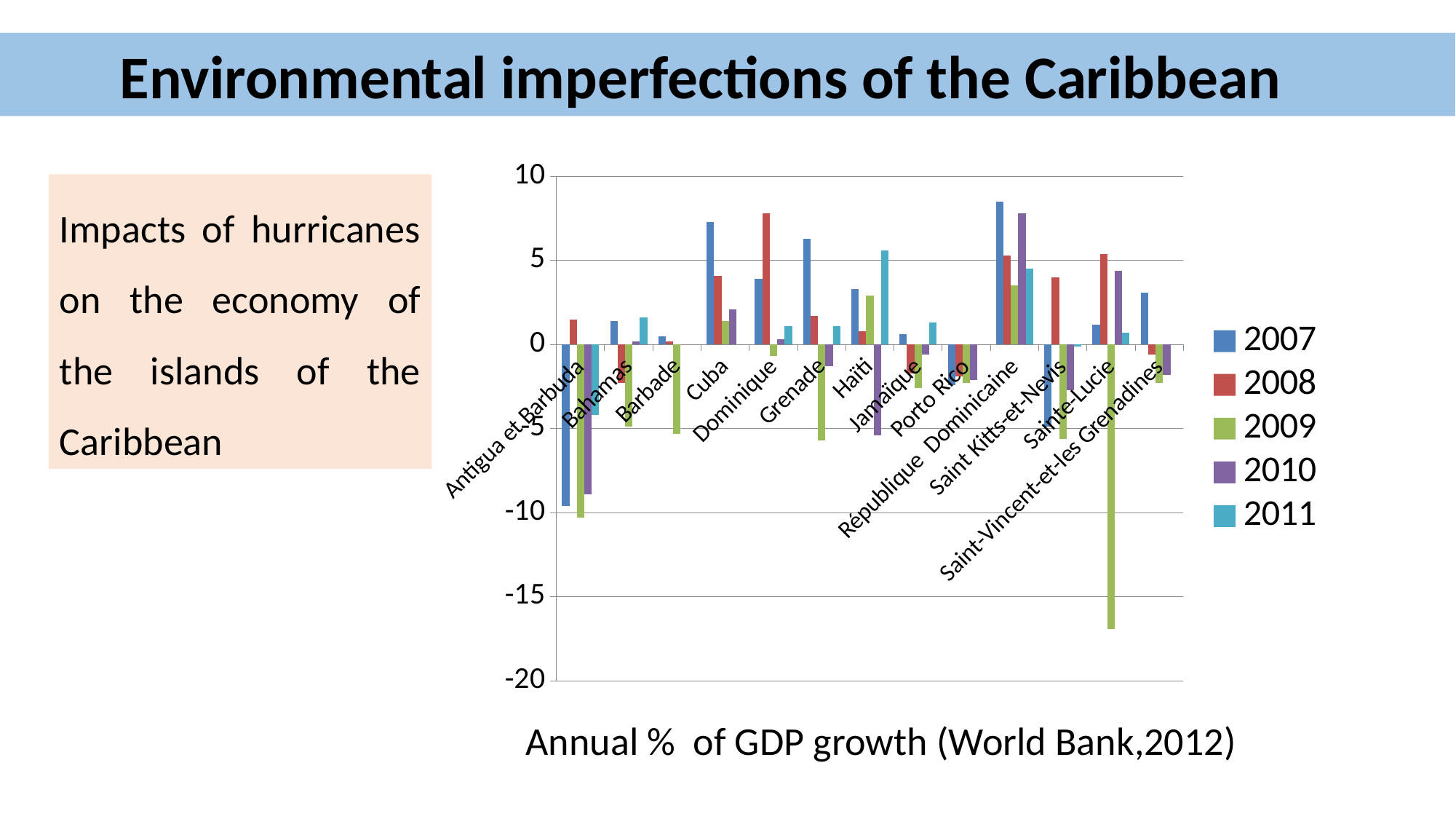
Which country has the lowest value for the 2009 series? Sainte-Lucie What caption appears below the chart describing the data? Annual % of GDP growth (World Bank,2012) For Cuba, which is larger: the 2007 value or the 2008 value? 2007 Is the 2008 value for Dominique greater or less than 5? greater How many series does the legend list? 5 Is the 2007 value for Antigua et Barbuda greater or less than -5? less Is the 2007 value for Cuba greater or less than 5? greater What kind of chart is shown on the slide? bar chart How many countries (categories) are shown on the x axis? 13 For Saint Kitts-et-Nevis, which is larger: the 2007 value or the 2008 value? 2008